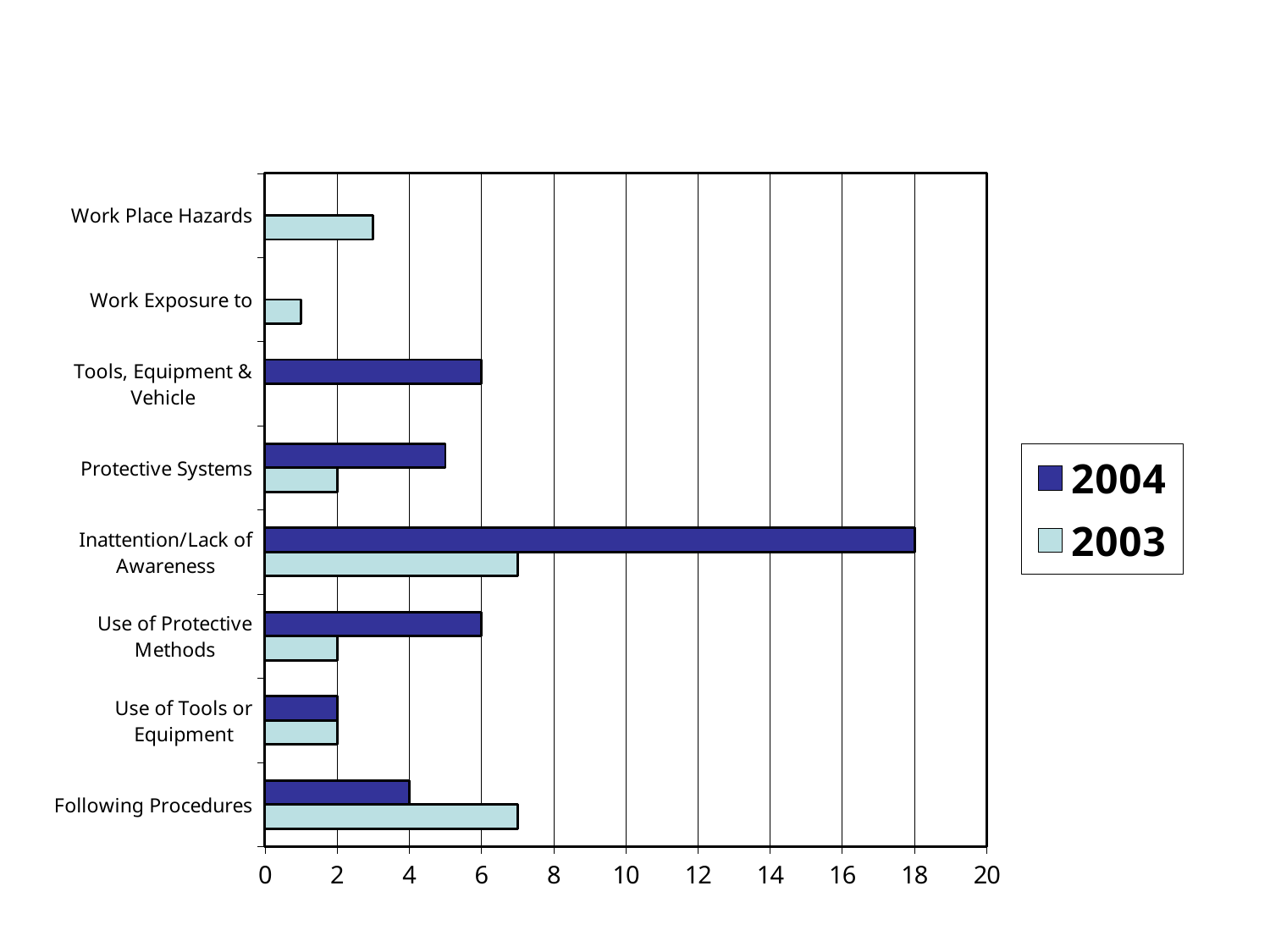
What is the difference between the 2004 values for Inattention/Lack of Awareness and Use of Protective Methods? 12 Which category has the highest 2004 value? Inattention/Lack of Awareness Is the 2003 value for Following Procedures greater or less than 6? greater What kind of chart is shown on the slide? bar chart How many series does the legend list? 2 What is the 2004 value for Inattention/Lack of Awareness? 18 What is the 2004 value for Tools, Equipment & Vehicle? 6 Is the 2003 value for Work Exposure to greater or less than 2? less What is the 2003 value for Use of Protective Methods? 2 Which is larger for Following Procedures, the 2004 value or the 2003 value? 2003 What is the 2004 value for Following Procedures? 4 How many categories are shown on the chart? 8